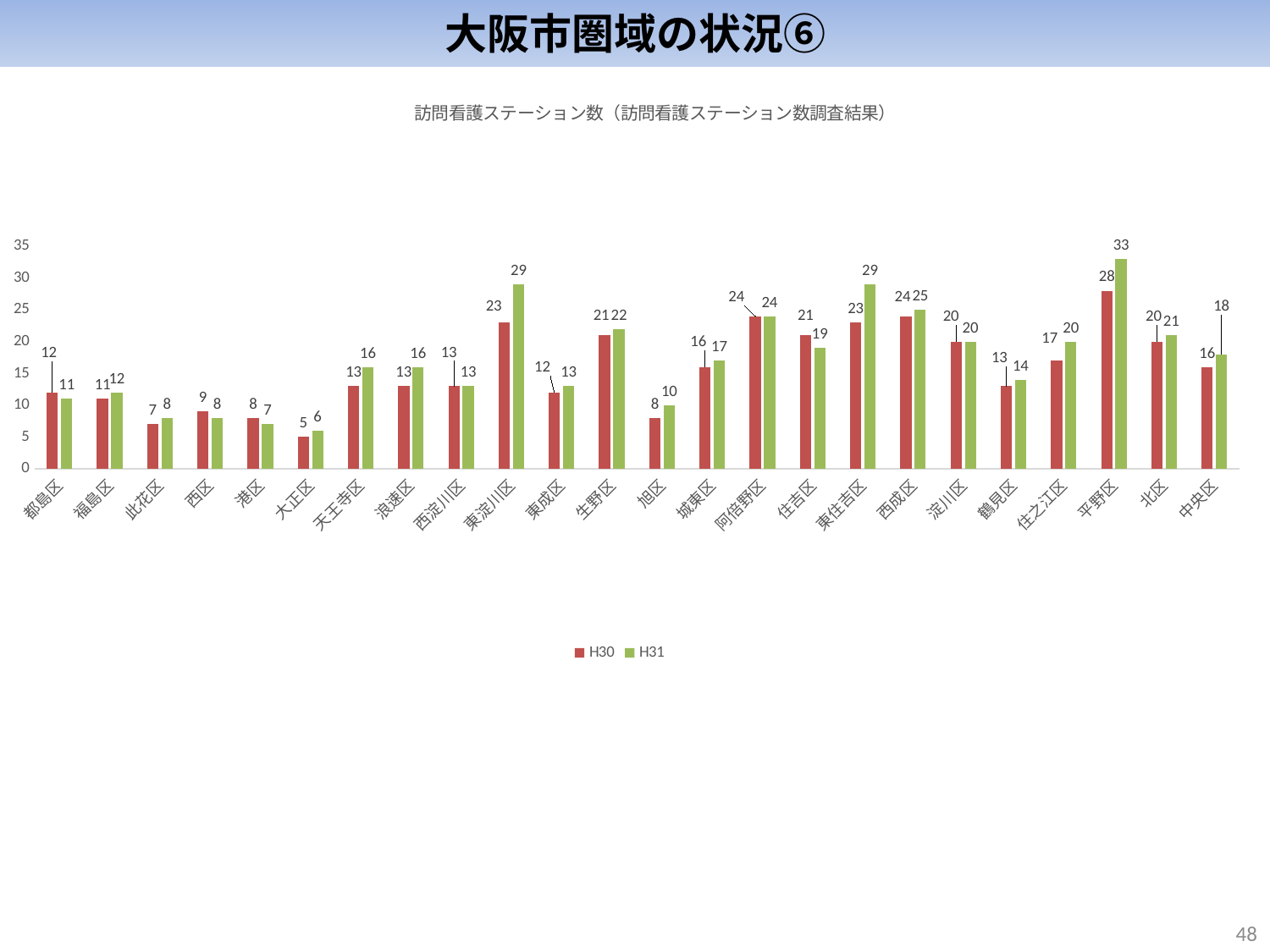
Which category has the lowest H30 value? 大正区 Which is larger for 住吉区, the H30 value or the H31 value? H30 What kind of chart is shown on the slide? bar chart Which category has the highest H31 value? 平野区 What is the H30 value for 阿倍野区? 24 How many categories are shown on the x axis? 24 What is the H31 value for 旭区? 10 How many series does the legend list? 2 What is the H30 value for 東淀川区? 23 What is the H31 value for 平野区? 33 What is the difference between the H31 and H30 values for 東住吉区? 6 What colour are the H31 bars? green